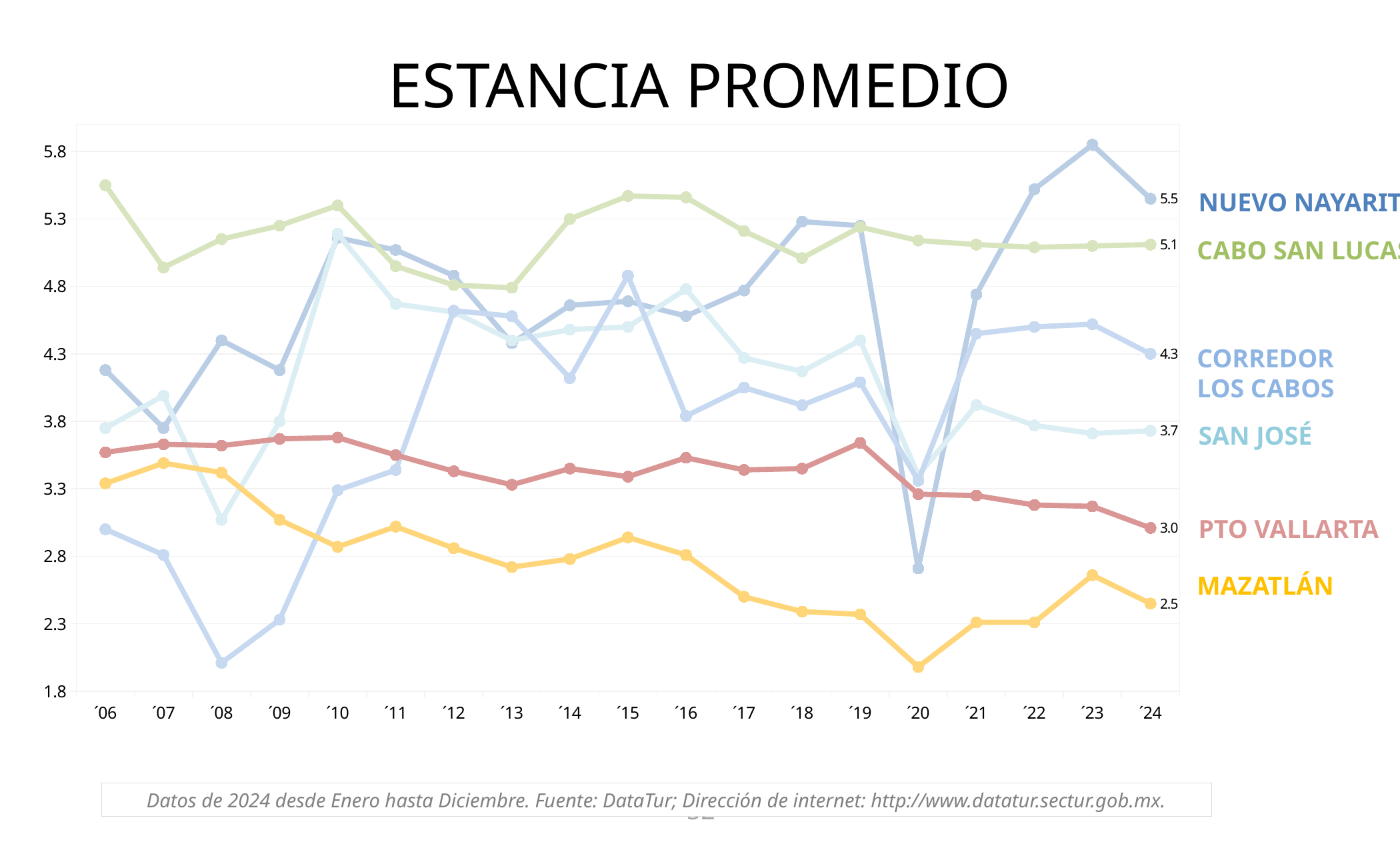
Which series has the highest value in '24? NUEVO NAYARIT What is the title of the chart? ESTANCIA PROMEDIO What is the difference between NUEVO NAYARIT and MAZATLÁN in '24? 3.0 What is the value for MAZATLÁN in '24? 2.5 What is the value for NUEVO NAYARIT in '24? 5.5 What kind of chart is shown on the slide? line chart How many series does the chart show? 6 Which series has the lowest value in '24? MAZATLÁN Is the value for MAZATLÁN in '20 greater or less than 2.3? less What is the value for PTO VALLARTA in '24? 3.0 What is the value for CABO SAN LUCAS in '24? 5.1 How many years are plotted along the x axis? 19